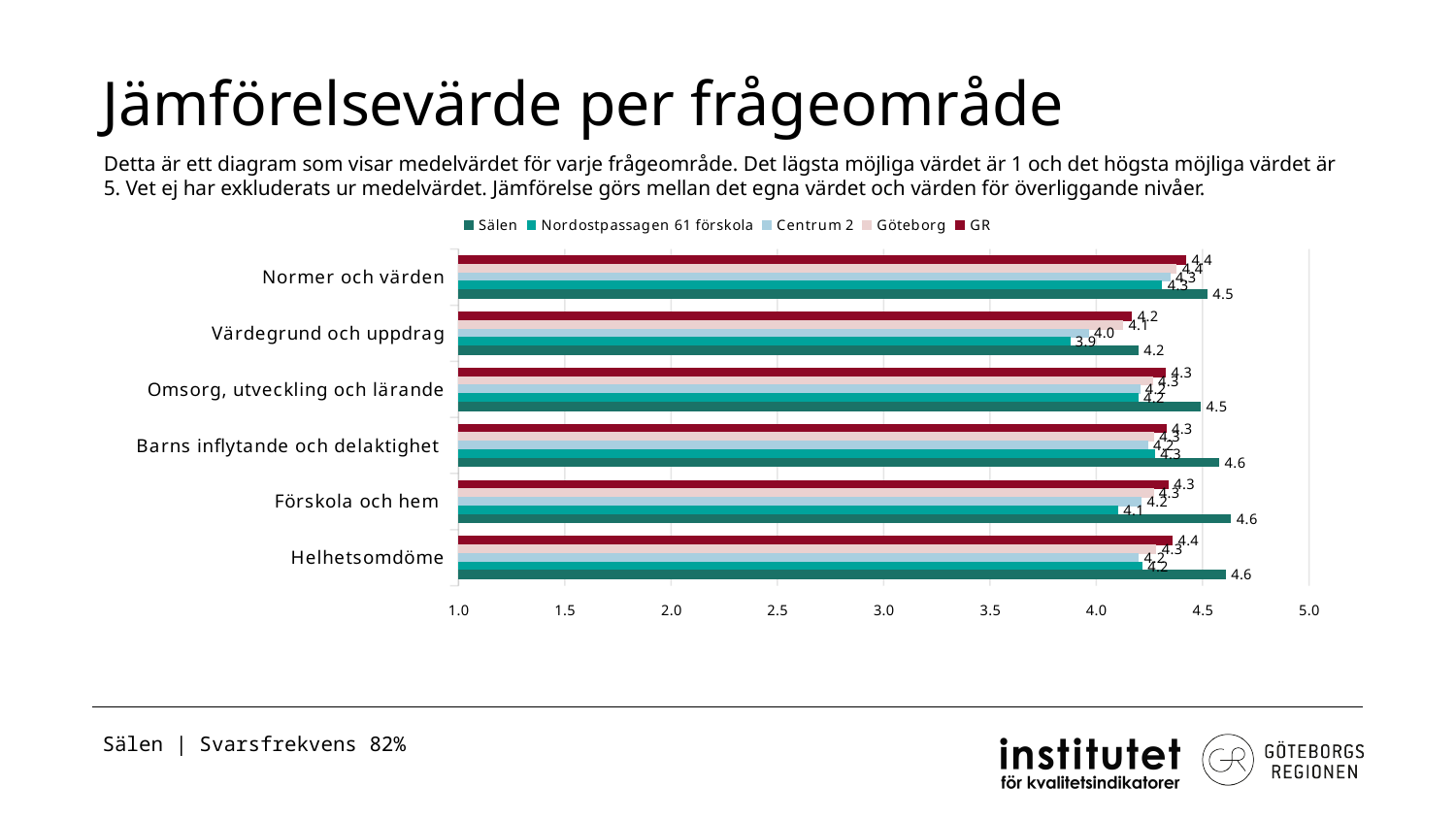
What is the value for GR in the category Helhetsomdöme? 4.4 How many question areas (categories) are shown on the y axis? 6 What is the value for Nordostpassagen 61 förskola in the category Förskola och hem? 4.1 What is the value for Nordostpassagen 61 förskola in the category Värdegrund och uppdrag? 3.9 What is the value for Sälen in the category Värdegrund och uppdrag? 4.2 How many series does the legend list? 5 What is the difference between the Sälen value and the Nordostpassagen 61 förskola value in the category Förskola och hem? 0.5 Which category has the lowest value for Sälen? Värdegrund och uppdrag Which is larger in the category Barns inflytande och delaktighet: the value for Sälen or the value for GR? Sälen Is the value for Nordostpassagen 61 förskola in Värdegrund och uppdrag greater or less than 4.0? less What kind of chart is shown on the slide? bar chart What is the value for Sälen in the category Normer och värden? 4.5